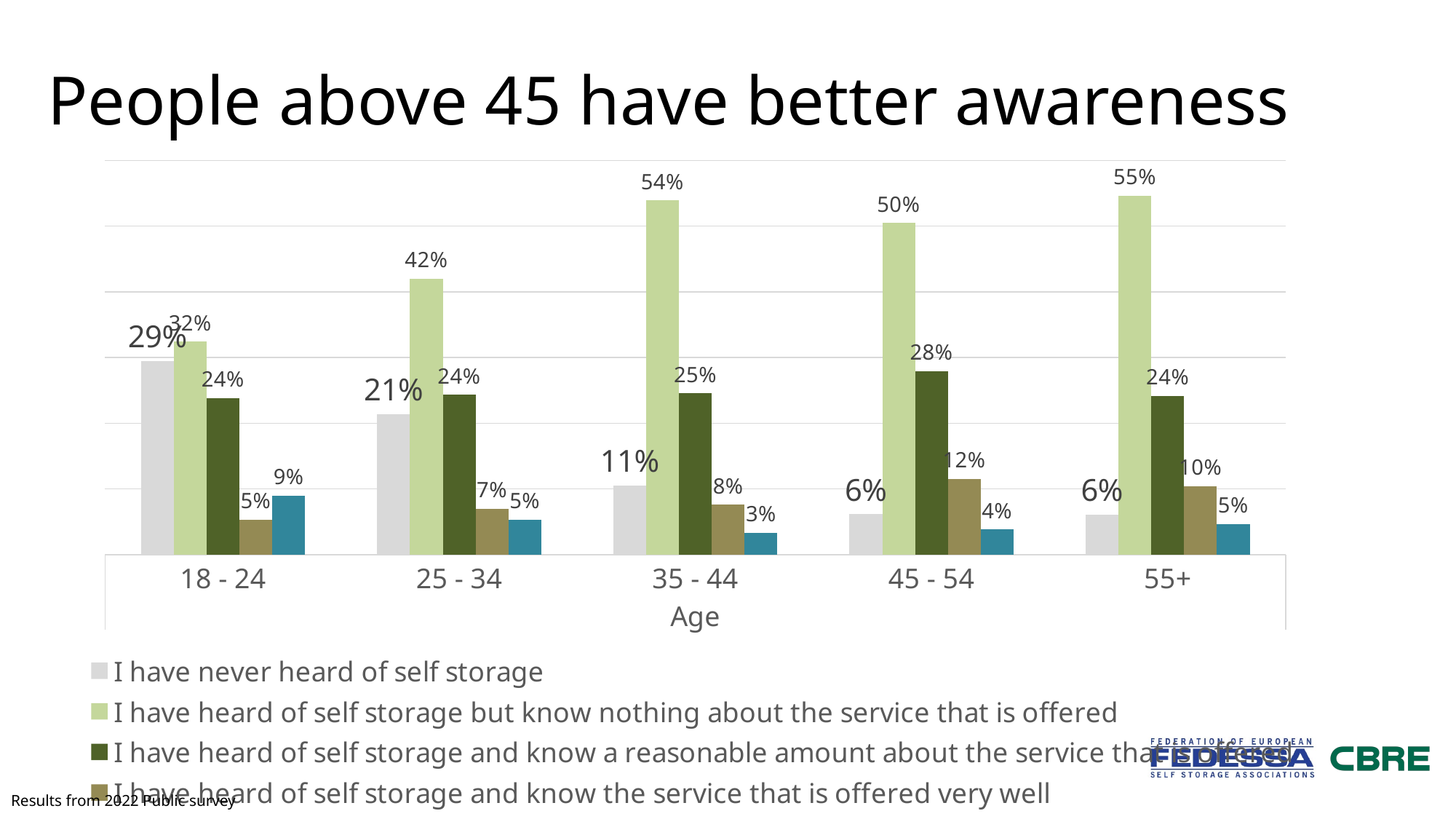
What percentage of people aged 18 - 24 have never heard of self storage? 29% Which age group has the highest value for 'I have heard of self storage but know nothing about the service that is offered'? 55+ What is the difference between the 'I have never heard of self storage' values for the 18 - 24 and 55+ age groups? 23% What kind of chart is shown on the slide? Bar chart Does the value for 'I have never heard of self storage' rise or fall as age increases from 18 - 24 to 45 - 54? Fall What is the value for 'I have heard of self storage but know nothing about the service that is offered' in the 35 - 44 age group? 54% What percentage of the 45 - 54 age group have heard of self storage and know the service that is offered very well? 12% How many age groups are shown on the x axis? 5 Which age group has the highest value for 'I have never heard of self storage'? 18 - 24 Which is larger: the 'I have heard of self storage and know a reasonable amount about the service' value for 45 - 54 or for 25 - 34? 45 - 54 What is the label of the x axis? Age Which age group has the lowest value for 'I have heard of self storage and know the service that is offered very well'? 18 - 24